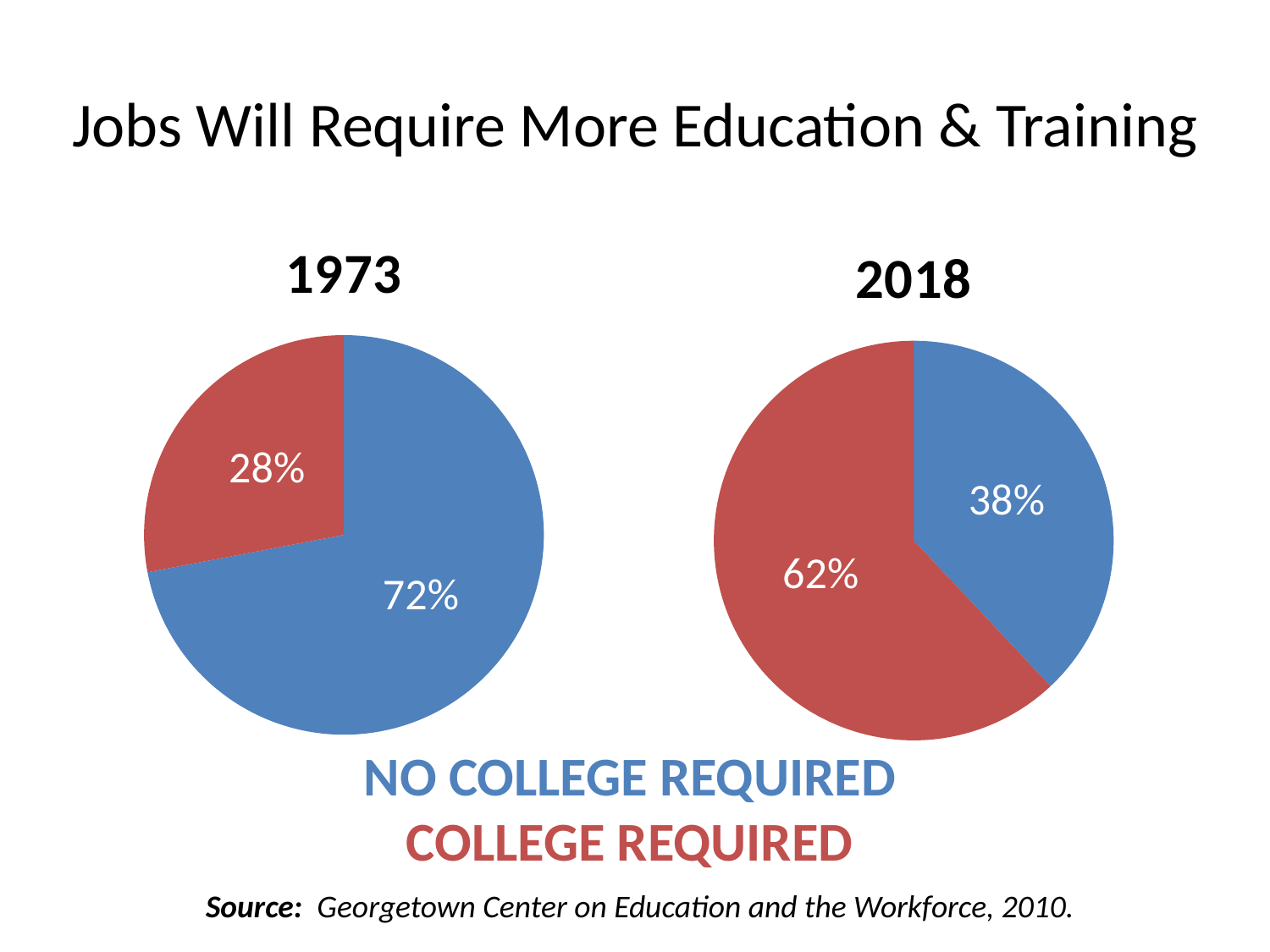
In the 1973 pie chart, what share of jobs required no college? 72% In the 2018 pie chart, which slice is larger: College Required or No College Required? College Required What is the title of the slide? Jobs Will Require More Education & Training In the 2018 pie chart, what share of jobs require college? 62% What type of chart is used on this slide? Pie chart What is the difference between the College Required share in 2018 and in 1973? 34% How many slices does the 2018 pie chart have? 2 In the 1973 pie chart, what is the difference between the No College Required and College Required shares? 44% In the 1973 pie chart, which category has the largest slice? No College Required In the 1973 pie chart, what share of jobs required college? 28% In the 2018 pie chart, what share of jobs require no college? 38% Which colour represents College Required in the pie charts? Red